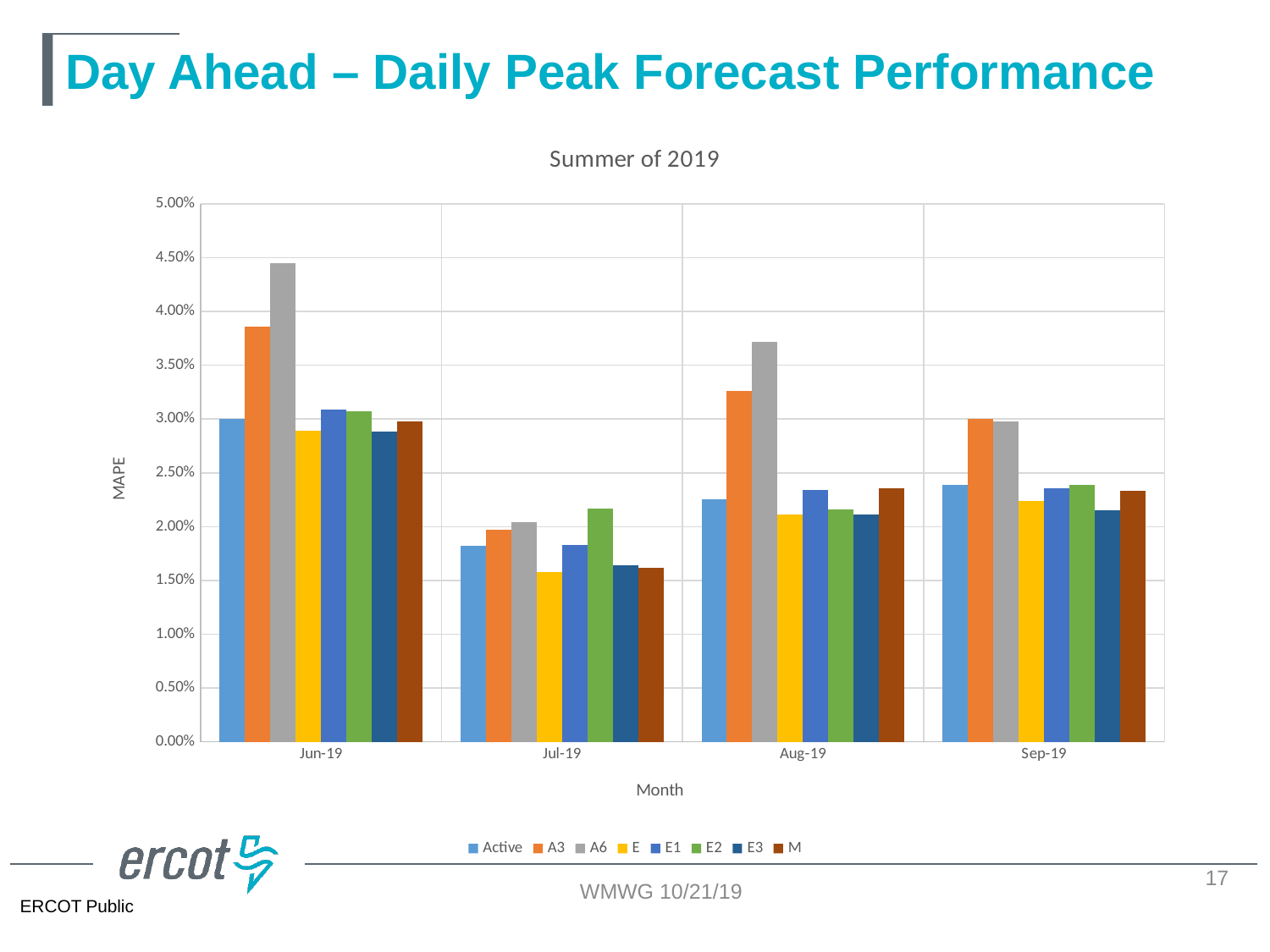
How many series does the legend list? 8 Is the value for A6 in Jun-19 greater or less than 4.00%? greater Is the value for A6 in Aug-19 greater or less than 3.50%? greater What is the label on the vertical axis? MAPE What is the title of the chart? Summer of 2019 In which month is the A6 bar the highest? Jun-19 In which month is the E bar the lowest? Jul-19 In Aug-19, which is larger, the A3 bar or the Active bar? A3 What kind of chart is shown on the slide? bar chart Which series has the highest bar in Jul-19? E2 Is the value for E in Jul-19 greater or less than 2.00%? less How many months are shown on the x axis? 4